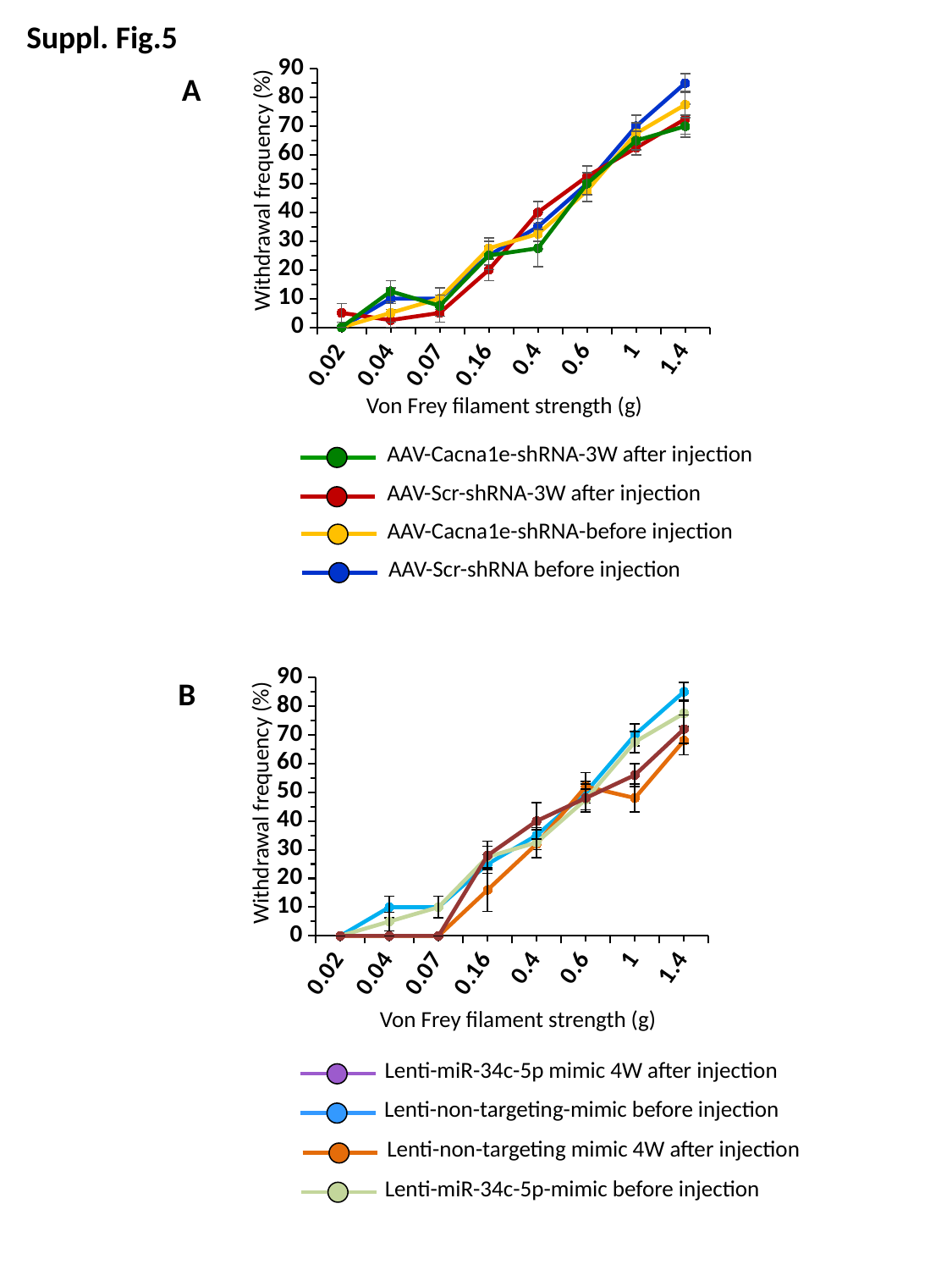
What type of chart is chart A? line chart In chart B, how many series does the legend list? 4 In chart A, how many series does the legend list? 4 In chart A, how many Von Frey filament strength categories are shown on the x axis? 8 In chart A, is the value for AAV-Cacna1e-shRNA-3W after injection at 0.02 g greater or less than 10? less What is the y-axis label of chart B? Withdrawal frequency (%) In chart A, is the value for AAV-Scr-shRNA before injection at 1.4 g greater or less than 80? greater In chart B, is the value for Lenti-non-targeting mimic 4W after injection at 0.16 g greater or less than 30? less In chart A, do the withdrawal frequency values generally rise or fall as filament strength increases along the x axis? rise In chart B, which series has the highest withdrawal frequency at 1.4 g? Lenti-non-targeting-mimic before injection In chart A, which series has the highest withdrawal frequency at 1.4 g? AAV-Scr-shRNA before injection